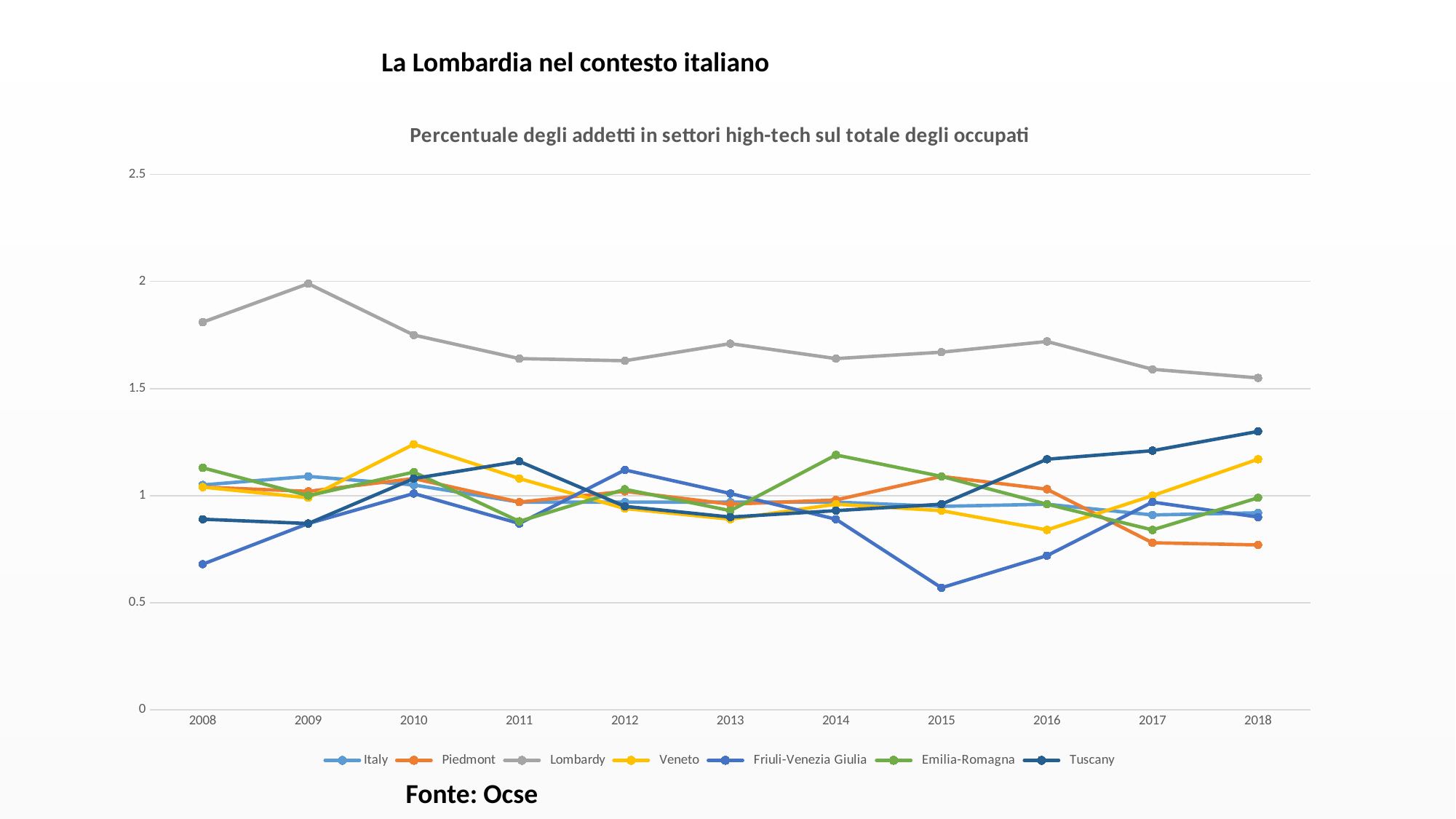
Does the Tuscany line rise or fall from 2014 to 2018? Rise How many years are shown on the x axis? 11 Which is larger in 2018, the value for Lombardy or the value for Tuscany? Lombardy Which series has the lowest value in 2015? Friuli-Venezia Giulia What is the title of the chart? Percentuale degli addetti in settori high-tech sul totale degli occupati Is the value for Tuscany in 2018 greater or less than 1? greater Is the value for Lombardy in 2009 greater or less than 1.5? greater Does the Lombardy line rise or fall from 2016 to 2018? Fall How many series does the legend list? 7 What kind of chart is shown on the slide? Line chart Is the value for Friuli-Venezia Giulia in 2015 greater or less than 1? less Which series has the highest value in 2009? Lombardy